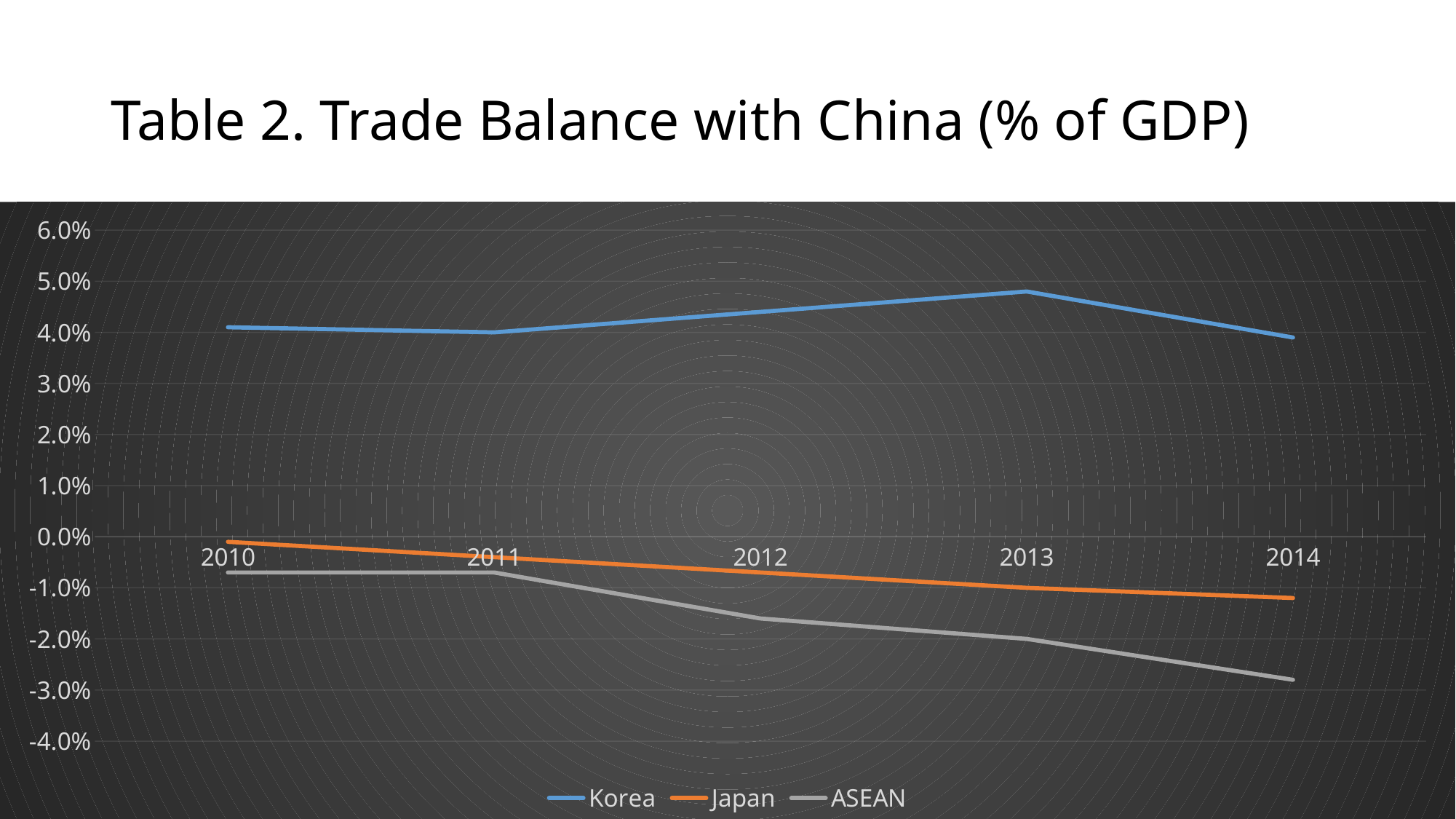
Does the ASEAN line rise or fall from 2011 to 2014? fall What kind of chart is shown on the slide? line chart In which year does the ASEAN line reach its lowest value? 2014 How many years are plotted along the x axis? 5 Is the value for Korea in 2013 greater or less than 4.0%? greater Which series has the larger value in 2014, Japan or ASEAN? Japan In which year does the Korea line reach its highest value? 2013 Is the value for Japan in 2010 greater or less than -1.0%? greater How many series does the legend list? 3 Is the value for ASEAN in 2014 greater or less than -2.0%? less Does the Japan line rise or fall from 2010 to 2014? fall What is the title of the chart on the slide? Table 2. Trade Balance with China (% of GDP)